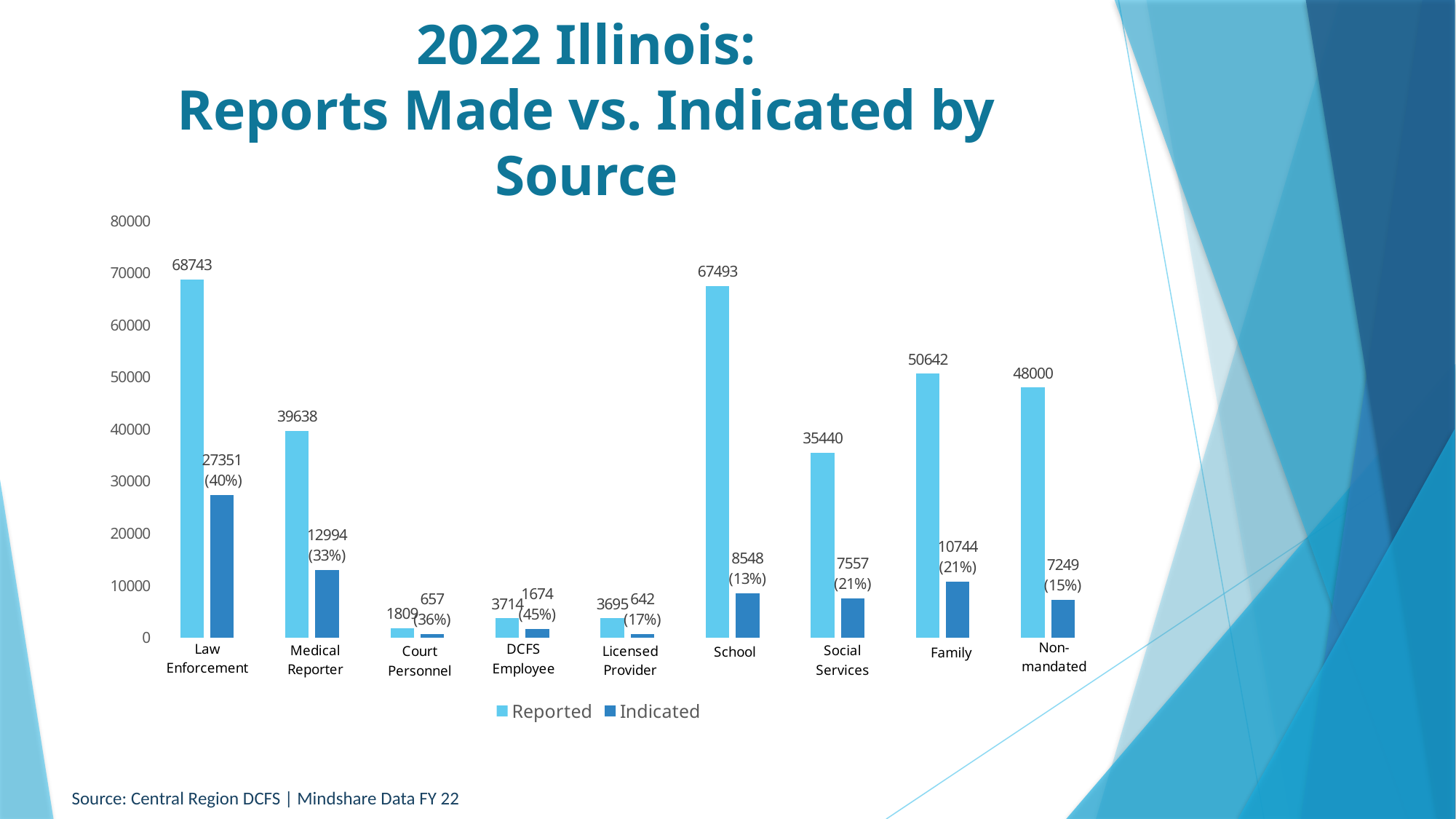
What is the Reported value for School? 67493 What is the difference between the Reported values for Law Enforcement and School? 1250 What is the Indicated value for Family? 10744 How many series does the legend list? 2 Which source has the highest Reported value? Law Enforcement What kind of chart is shown on the slide? Bar chart Which has a larger Reported value, Family or Non-mandated? Family How many source categories are shown on the x axis? 9 What percentage is shown next to the Indicated value for DCFS Employee? 45% What is the Reported value for Social Services? 35440 What is the difference between the Reported and Indicated values for Medical Reporter? 26644 Which source has the lowest Indicated value? Licensed Provider